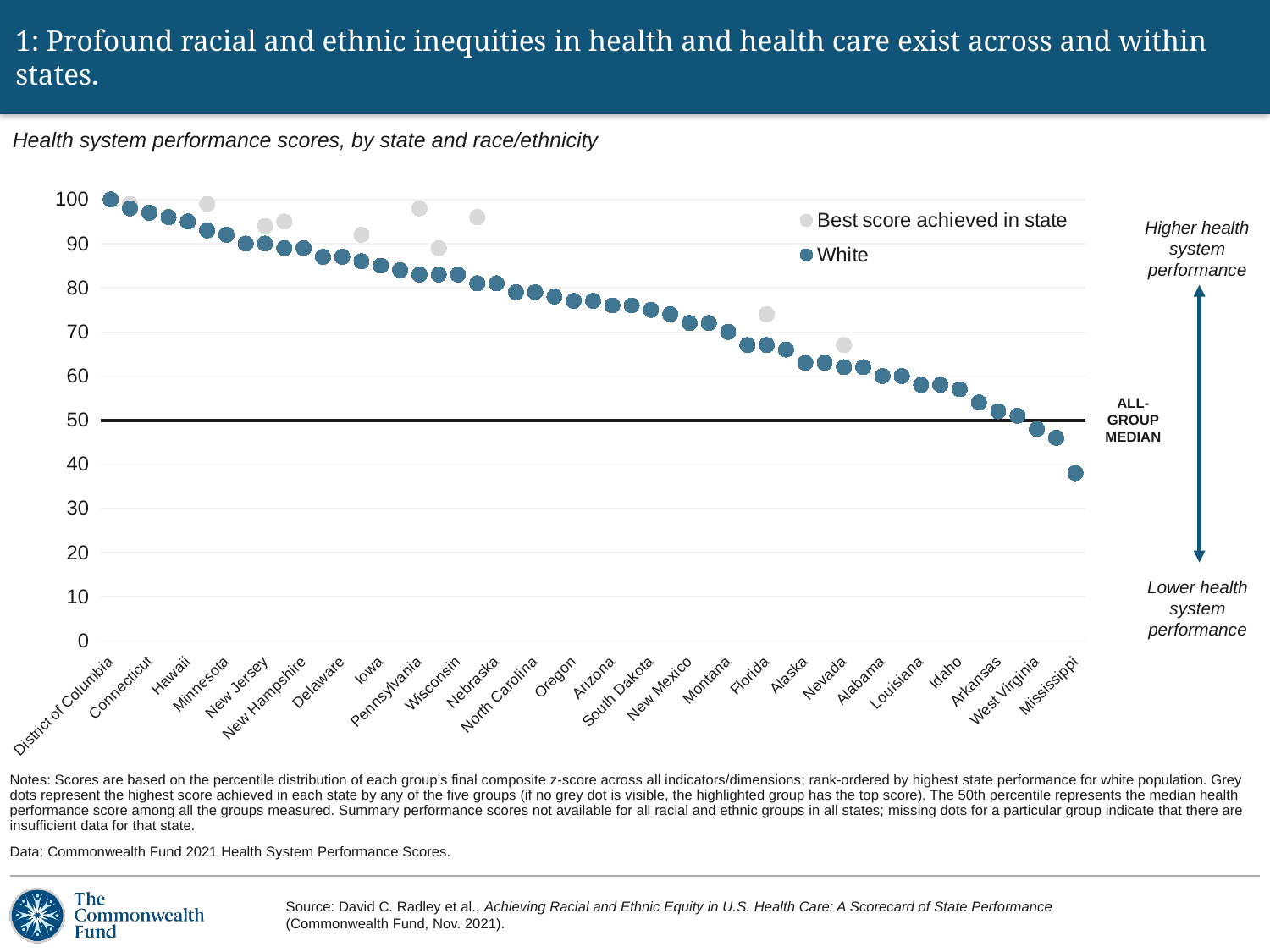
What are the two series named in the legend? Best score achieved in state; White Is the White score for West Virginia greater or less than 60? less At what value on the y axis is the ALL-GROUP MEDIAN line drawn? 50 Which has the larger White score, District of Columbia or Mississippi? District of Columbia Is the White score for Mississippi greater or less than 50? less What kind of chart is shown on the slide? Scatter (dot) chart What is the subtitle describing the chart's content? Health system performance scores, by state and race/ethnicity Is the White score for Connecticut greater or less than 90? greater Which state has the lowest White health system performance score? Mississippi Which state has the highest White health system performance score? District of Columbia How many series does the legend list? 2 Do the White scores rise or fall moving from left to right along the x axis? Fall